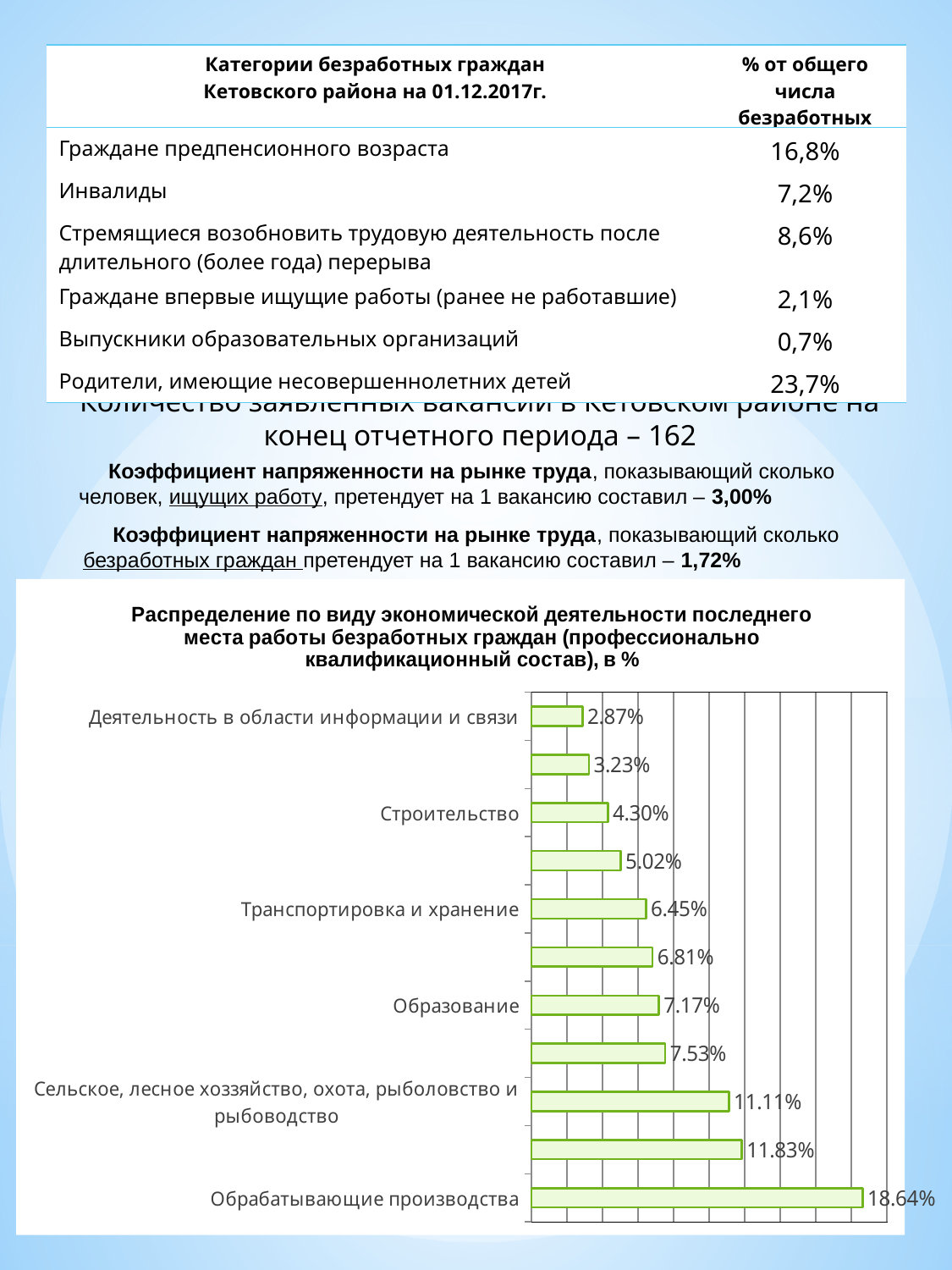
Which category has the highest value in the bar chart? Обрабатывающие производства How many bars are plotted in the bar chart? 11 Which category has the lowest value in the bar chart? Деятельность в области информации и связи What is the value for Образование in the bar chart? 7.17% What type of chart is shown on the slide? bar chart What is the title of the bar chart? Распределение по виду экономической деятельности последнего места работы безработных граждан (профессионально квалификационный состав), в % What is the difference between the values for Обрабатывающие производства and Образование in the bar chart? 11.47% What is the value for Сельское, лесное хозяйство, охота, рыболовство и рыбоводство in the bar chart? 11.11% What is the value for Транспортировка и хранение in the bar chart? 6.45% What is the value for Строительство in the bar chart? 4.30% Which has a larger value in the bar chart, Строительство or Транспортировка и хранение? Транспортировка и хранение What is the value for Обрабатывающие производства in the bar chart? 18.64%